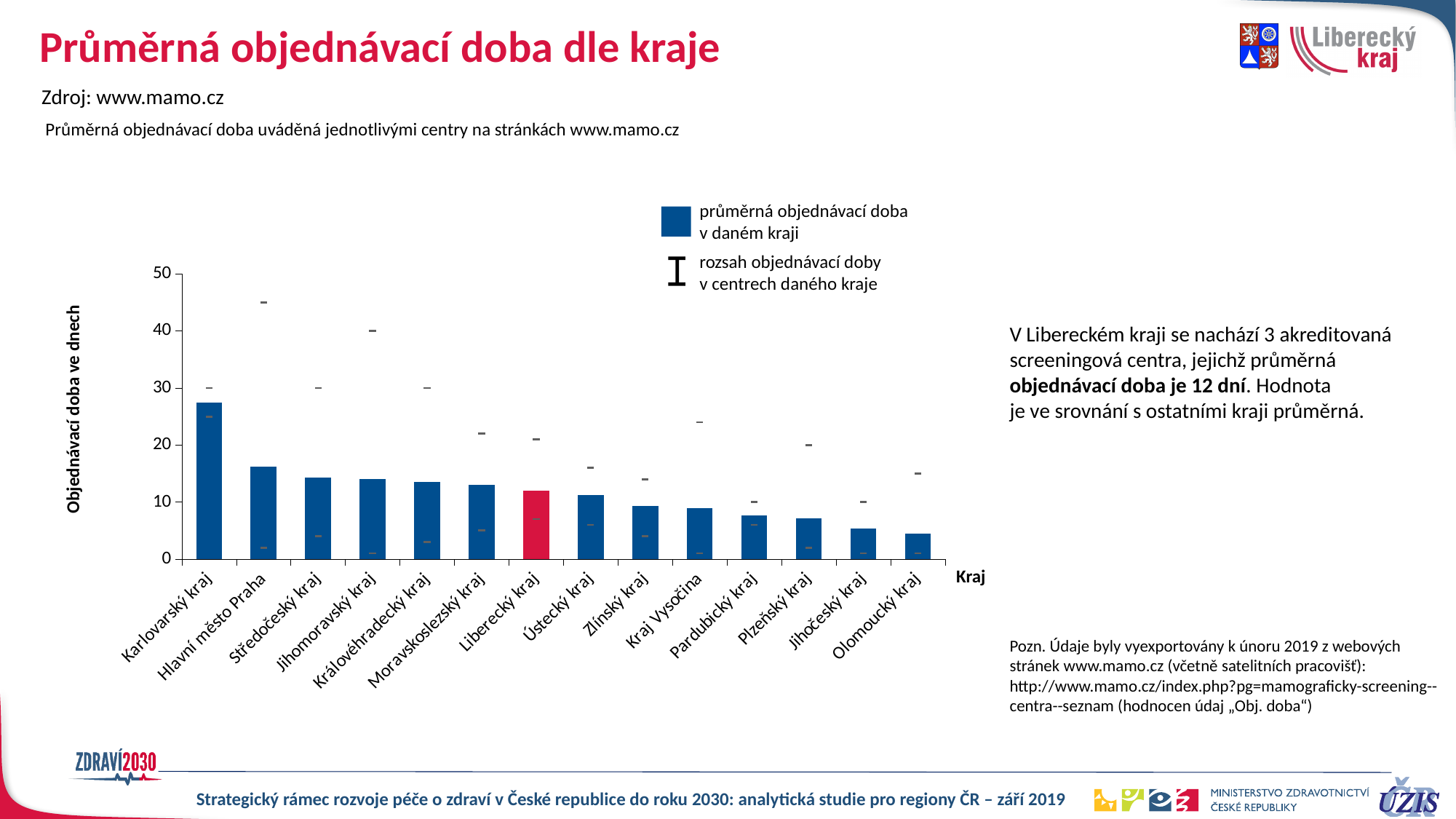
Is the value for Karlovarský kraj greater or less than 20? greater Which is larger, the value for Karlovarský kraj or for Hlavní město Praha? Karlovarský kraj Which region has the lowest average ordering time? Olomoucký kraj How many regions (kraje) are plotted on the x axis? 14 Is the value for Olomoucký kraj greater or less than 10? less Which region has the highest average ordering time (průměrná objednávací doba)? Karlovarský kraj What kind of chart is shown on the slide? bar chart Which is larger, the value for Zlínský kraj or for Jihočeský kraj? Zlínský kraj Do the bar values rise or fall from left to right along the x axis? fall Which region's bar is highlighted in red? Liberecký kraj Is the value for Hlavní město Praha greater or less than 10? greater How many entries does the chart legend list? 2